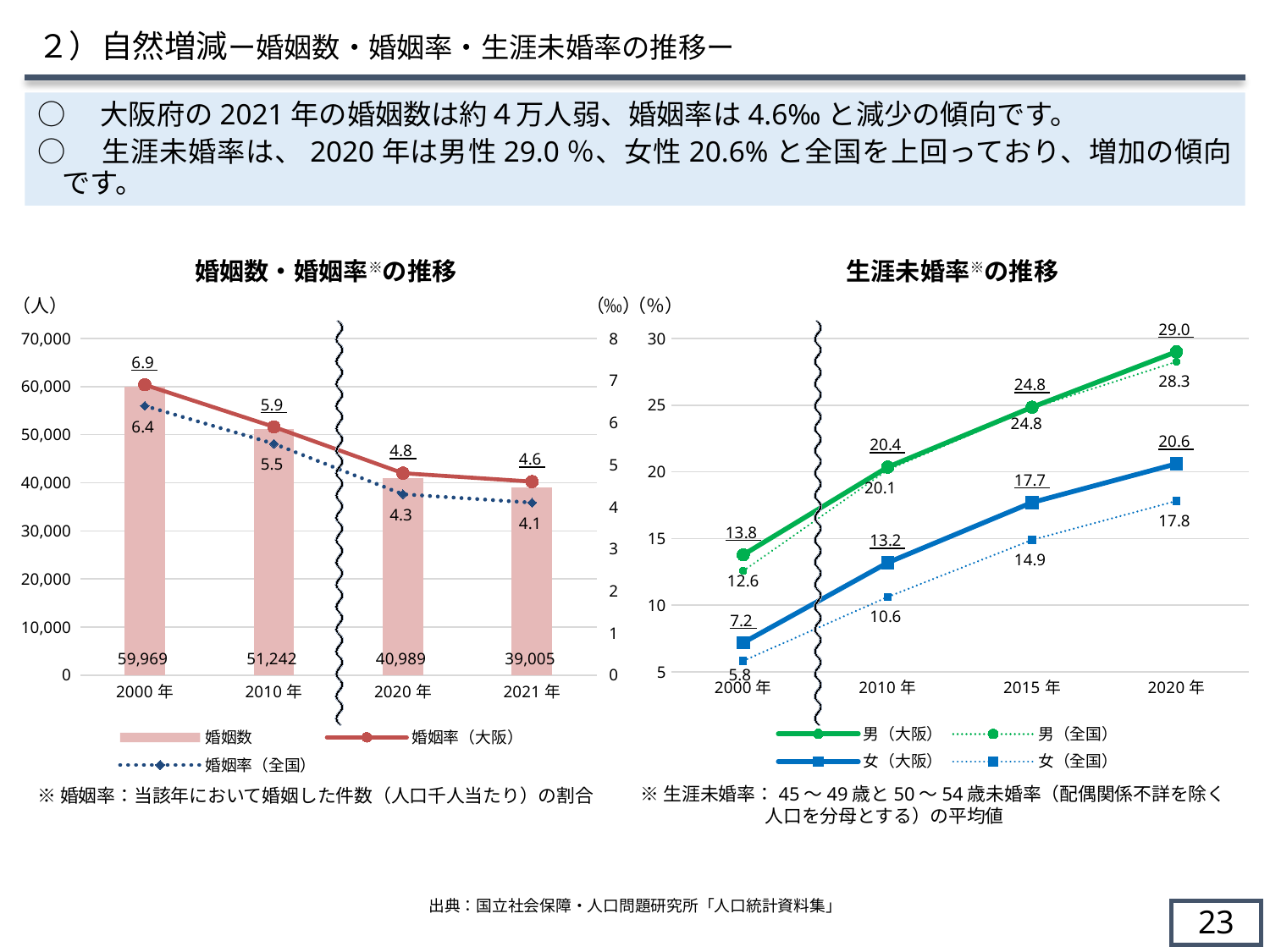
「生涯未婚率の推移」のグラフで、女（全国）の値が最も低い年はどれですか。 2000年 「婚姻数・婚姻率の推移」のグラフで、2020年の婚姻率は大阪と全国のどちらが高いですか。 大阪 「生涯未婚率の推移」のグラフで、2000年の男（全国）の値はいくつですか。 12.6 「生涯未婚率の推移」のグラフで、2020年の男（大阪）と男（全国）の差はいくつですか。 0.7 「婚姻数・婚姻率の推移」のグラフで、2000年と2021年の婚姻数の差はいくつですか。 20,964 「婚姻数・婚姻率の推移」のグラフで、婚姻率（大阪）は2000年から2021年にかけて上昇していますか、下降していますか。 下降 「生涯未婚率の推移」のグラフはどの種類のグラフですか。 折れ線グラフ 「婚姻数・婚姻率の推移」のグラフで、2021年の婚姻数はいくつですか。 39,005 「婚姻数・婚姻率の推移」のグラフで、2010年の婚姻率（大阪）はいくつですか。 5.9 「生涯未婚率の推移」のグラフで、2020年の女（大阪）の値はいくつですか。 20.6 「婚姻数・婚姻率の推移」のグラフで、凡例にはいくつの系列がありますか。 3 「婚姻数・婚姻率の推移」のグラフで、婚姻数が最も多い年はどれですか。 2000年